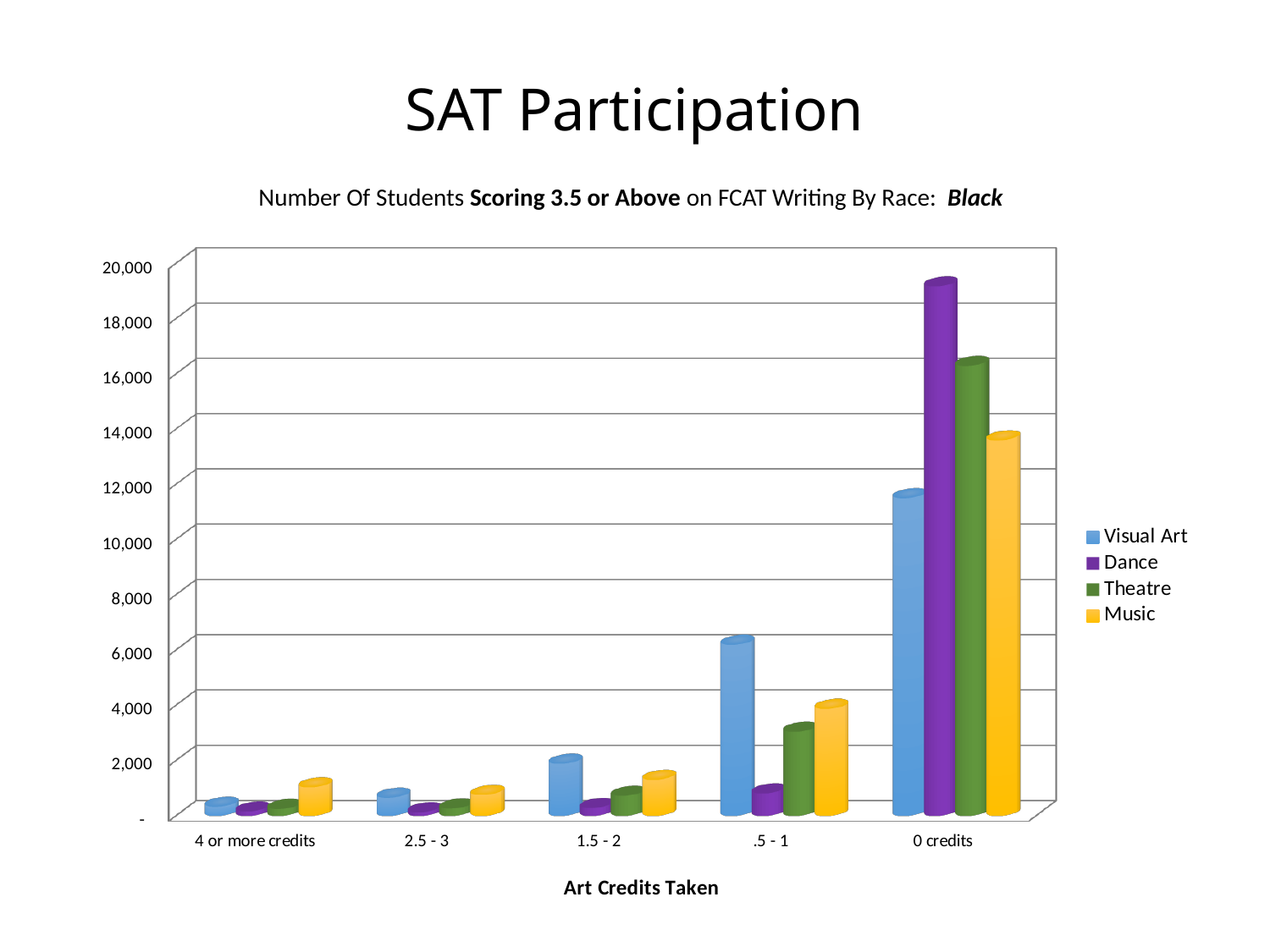
Which series has the highest value in the 0 credits category? Dance Which series has the lowest value in the .5 - 1 credits category? Dance Is the value for Dance in the 0 credits category greater or less than 18,000? greater How many art-credit categories are shown on the x axis? 5 Which series has the highest value in the .5 - 1 credits category? Visual Art Do the Visual Art values rise or fall moving from 4 or more credits to 0 credits along the x axis? rise What kind of chart is shown on the slide? bar chart How many series does the legend list? 4 In the 0 credits category, which is larger: Theatre or Music? Theatre Is the value for Dance in the .5 - 1 credits category greater or less than 2,000? less Is the value for Visual Art in the .5 - 1 credits category greater or less than 4,000? greater What is the title of the x axis? Art Credits Taken